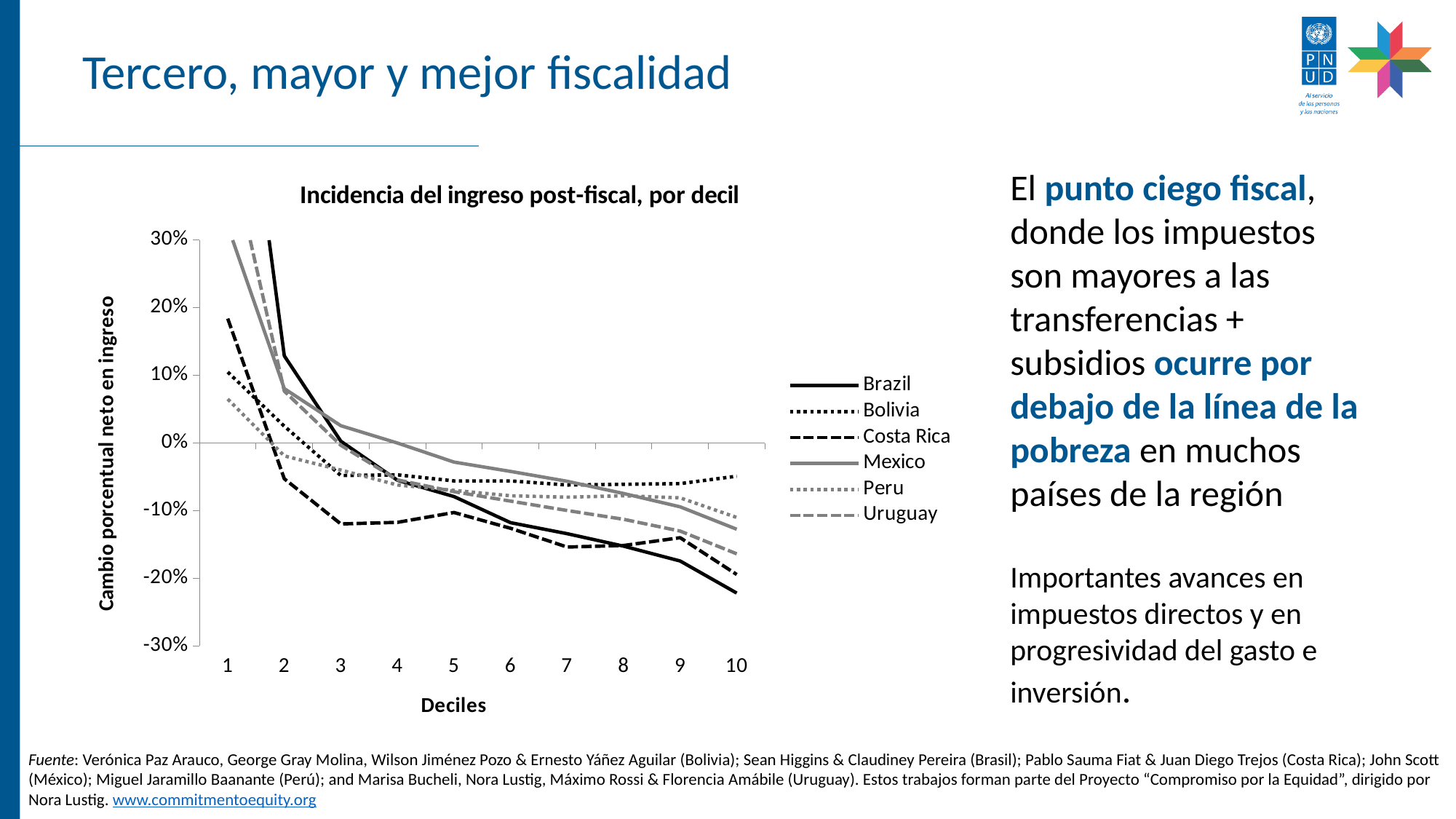
What kind of chart is shown on the slide? line chart Is the value for Brazil at decile 10 greater or less than -20%? less Which country has the lowest value at decile 10? Brazil Is the value for Costa Rica at decile 3 greater or less than -10%? less Is the value for Brazil at decile 2 greater or less than 10%? greater Does the Brazil line rise or fall as the deciles increase from 1 to 10? fall How many deciles are shown on the x axis of the chart? 10 At decile 1, which is larger: the value for Mexico or the value for Peru? Mexico What is the label of the vertical axis of the chart? Cambio porcentual neto en ingreso How many series does the legend of the chart list? 6 What is the title of the chart? Incidencia del ingreso post-fiscal, por decil